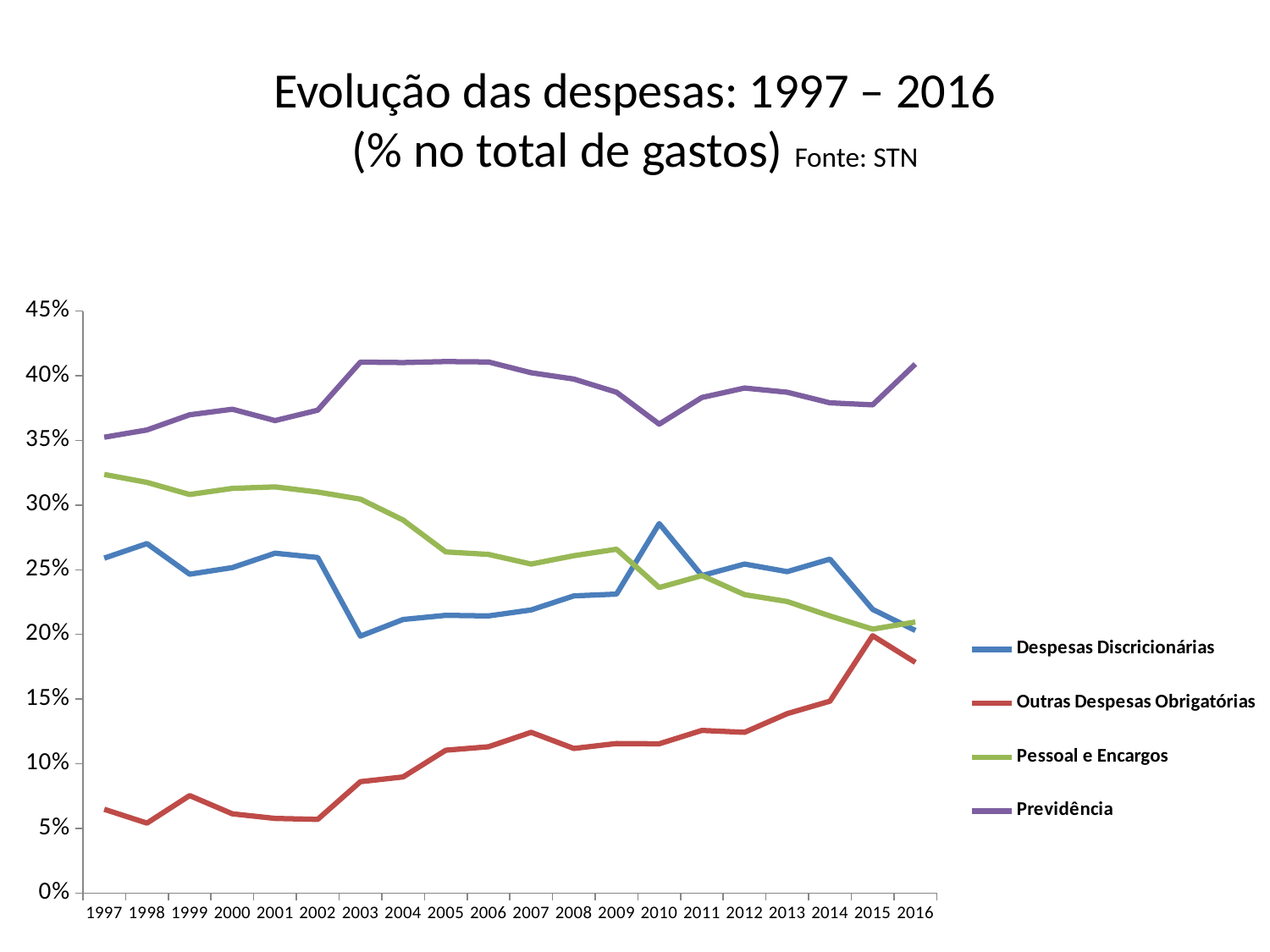
In 2010, which is larger: Despesas Discricionárias or Pessoal e Encargos? Despesas Discricionárias In which year does Despesas Discricionárias reach its highest value? 2010 What kind of chart is shown on the slide? line chart Does Pessoal e Encargos generally rise or fall from 1997 to 2016? fall Which series has the lowest value in 1997? Outras Despesas Obrigatórias Is the value for Previdência in 2003 greater or less than 40%? greater Which series has the highest value in 2016? Previdência How many years are shown on the x axis? 20 How many series does the legend list? 4 Is the value for Outras Despesas Obrigatórias in 1997 greater or less than 10%? less Is the value for Pessoal e Encargos in 1997 greater or less than 30%? greater